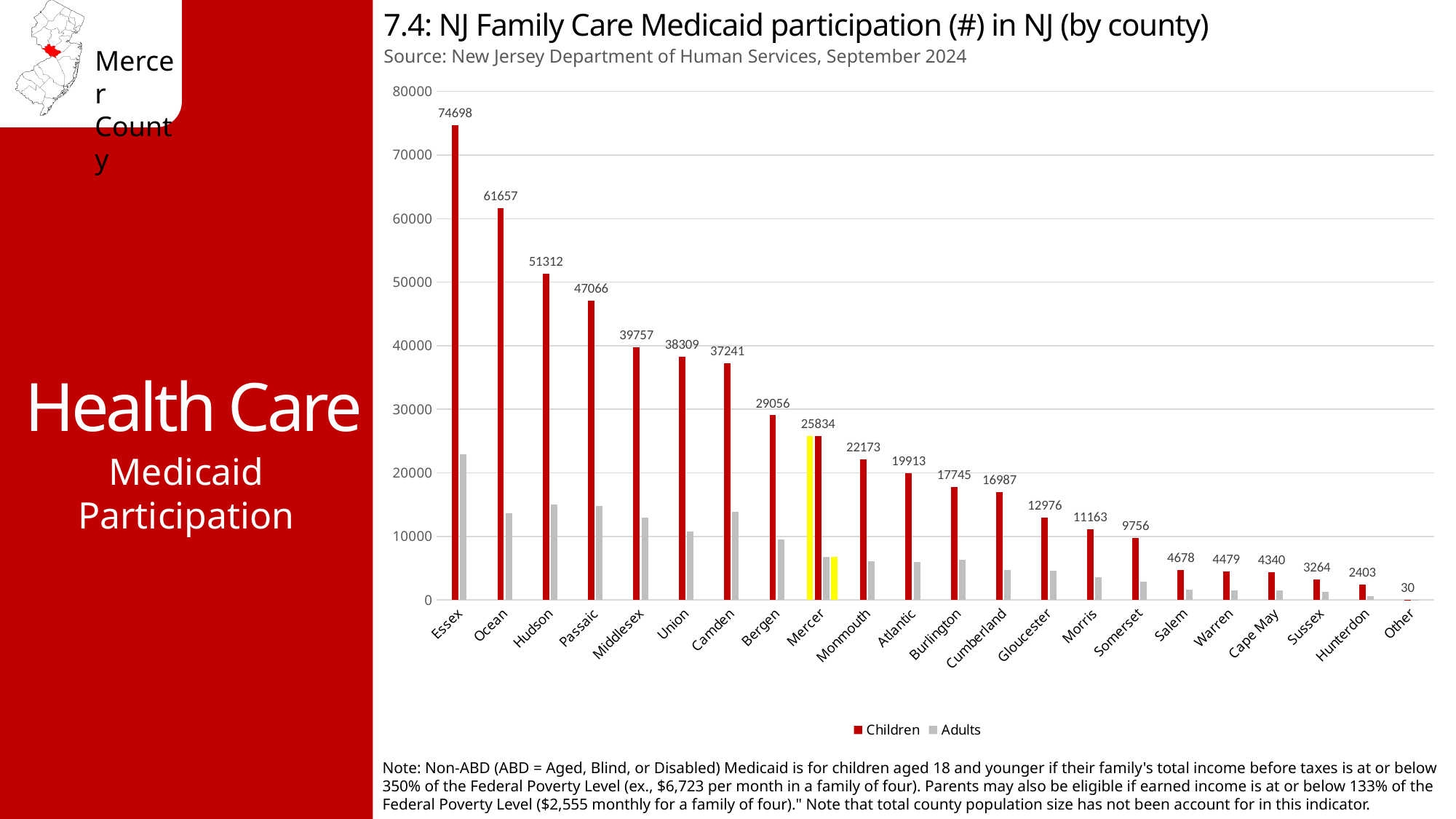
How many series does the legend list? 2 Which category has the lowest Children value? Other Which has a larger Children value, Bergen or Monmouth? Bergen Which county has the highest Children value? Essex What is the Children value for Somerset? 9756 Do the Children values rise or fall moving from left to right along the x axis? fall What is the Children value for Mercer? 25834 How many categories are shown on the x axis? 22 What is the difference between the Children values for Ocean and Hudson? 10345 What kind of chart is shown on the slide? bar chart Is the Adults value for Essex greater or less than 20000? greater What is the Children value for Essex? 74698